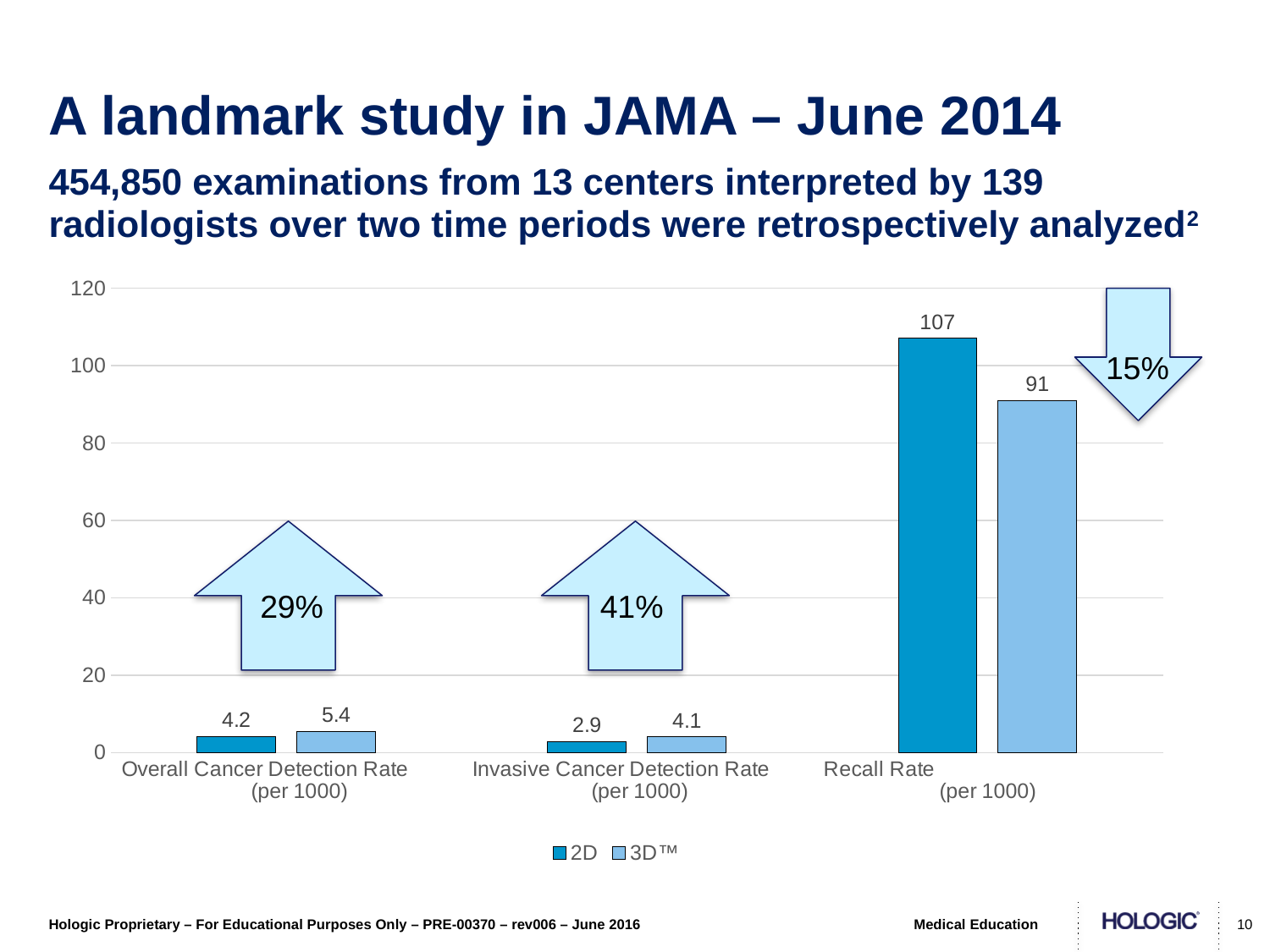
How many categories are shown on the x axis? 3 What is the 3D™ value for Invasive Cancer Detection Rate (per 1000)? 4.1 For Overall Cancer Detection Rate (per 1000), which is larger, the 2D value or the 3D™ value? 3D™ Which category has the highest 2D value? Recall Rate (per 1000) Is the 3D™ value for Recall Rate (per 1000) greater or less than 100? less What is the 2D value for Recall Rate (per 1000)? 107 What is the 3D™ value for Recall Rate (per 1000)? 91 How many series does the legend list? 2 What kind of chart is shown on the slide? bar chart What is the difference between the 2D and 3D™ values for Recall Rate (per 1000)? 16 Which category has the lowest 3D™ value? Invasive Cancer Detection Rate (per 1000) What is the 2D value for Overall Cancer Detection Rate (per 1000)? 4.2